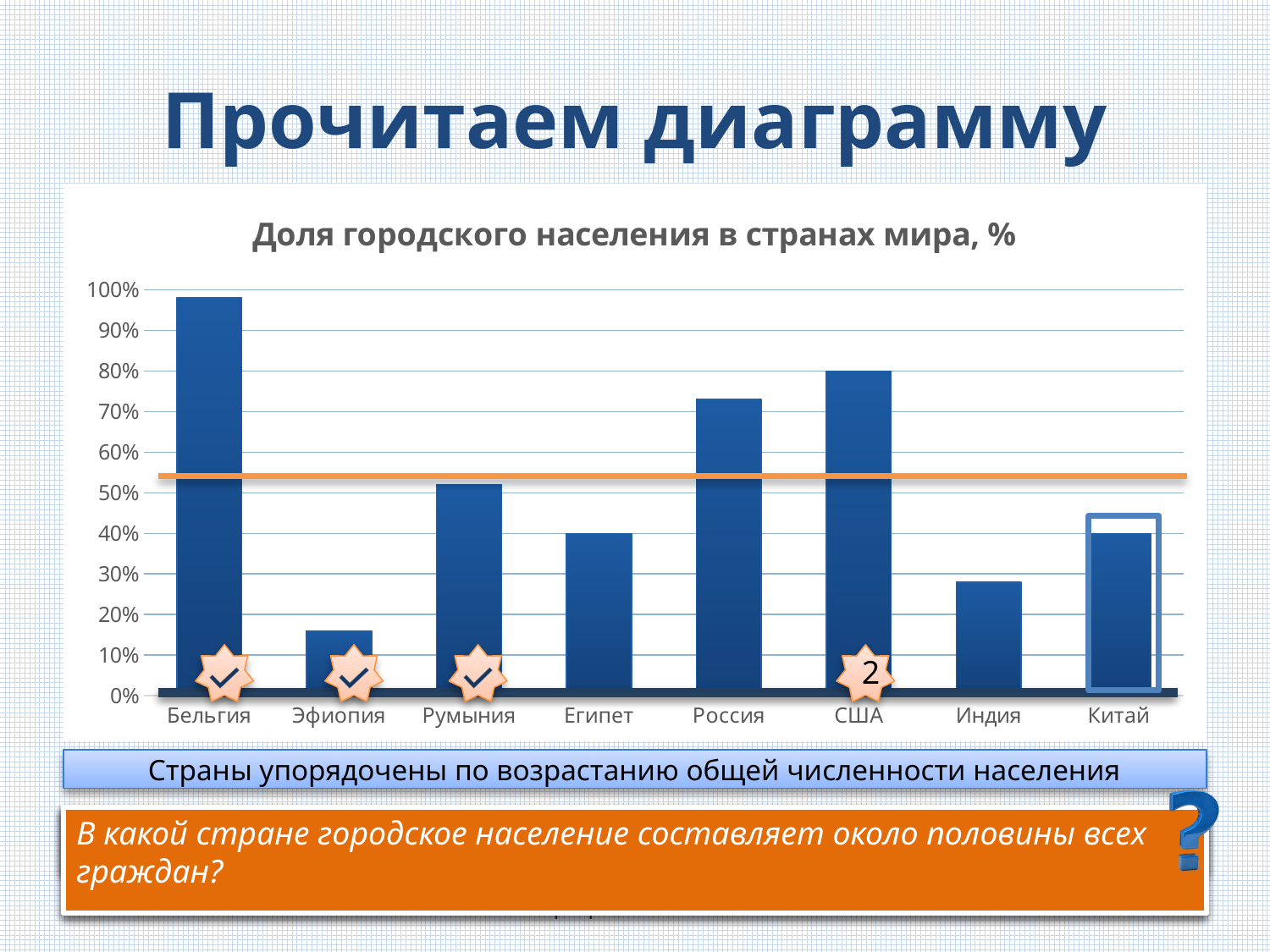
Is the value for Эфиопия greater or less than 20%? less How many countries are shown on the x axis of the chart? 8 What is the title of the chart? Доля городского населения в странах мира, % Which country has the highest share of urban population in the chart? Бельгия Which has the larger value in the chart, Бельгия or Индия? Бельгия Is the value for Россия greater or less than 70%? greater Is the value for Бельгия greater or less than 90%? greater Which has the larger value in the chart, США or Россия? США Which country is listed last on the x axis of the chart? Китай Which country has the lowest share of urban population in the chart? Эфиопия What kind of chart is shown on the slide? bar chart